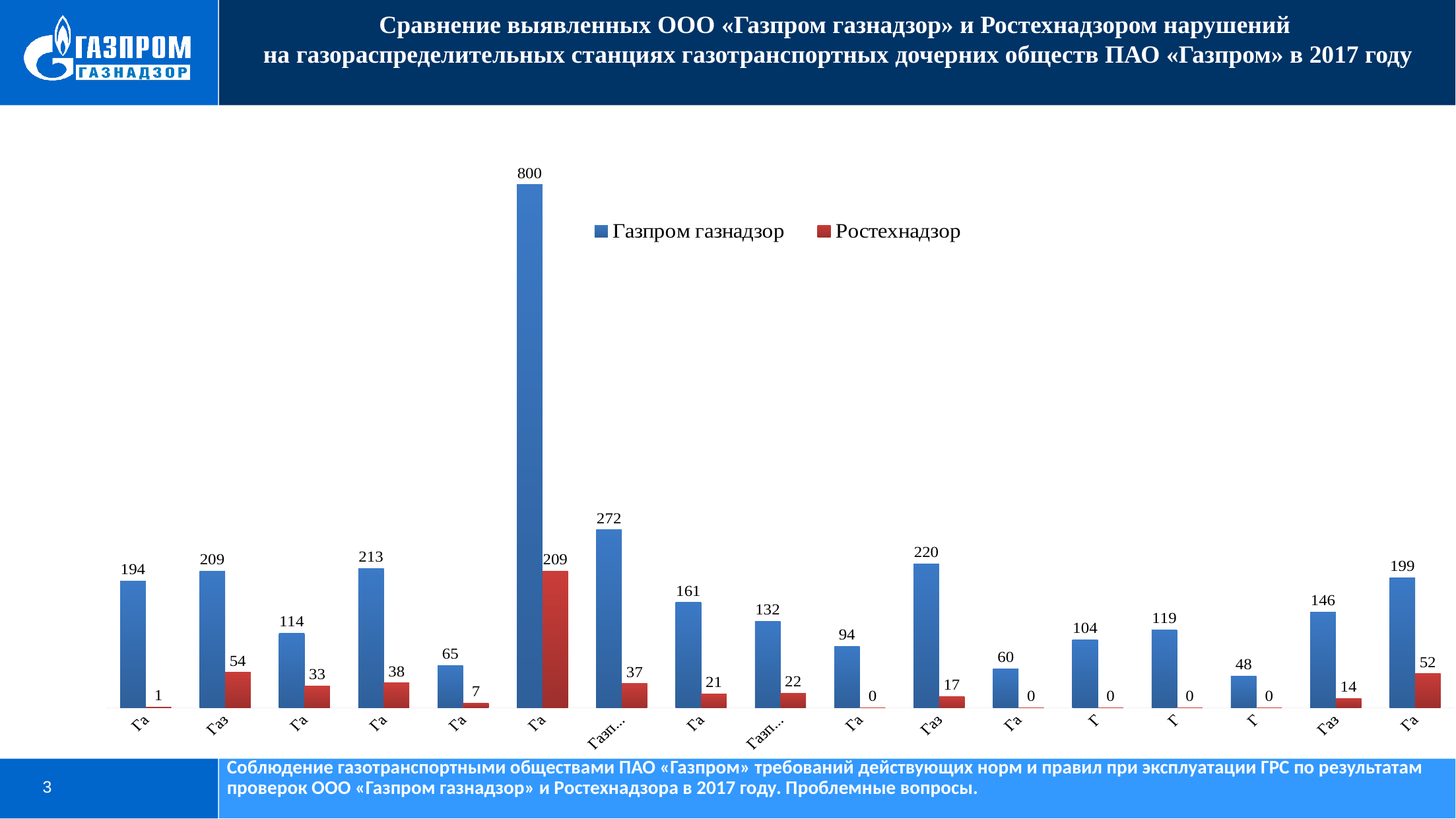
How many categories are plotted along the x axis? 17 What colour are the Ростехнадзор bars? red In the category with the tallest bars, what is the difference between the Газпром газнадзор value (800) and the Ростехнадзор value (209)? 591 What are the two series named in the legend? Газпром газнадзор and Ростехнадзор What is the second-highest value in the Газпром газнадзор series? 272 What is the Ростехнадзор value for the first category from the left? 1 What kind of chart is shown on the slide? bar chart How many categories have a Ростехнадзор value of 0? 5 How many series does the legend list? 2 What is the highest value in the Газпром газнадзор series? 800 What is the lowest value in the Газпром газнадзор series? 48 What is the highest value in the Ростехнадзор series? 209